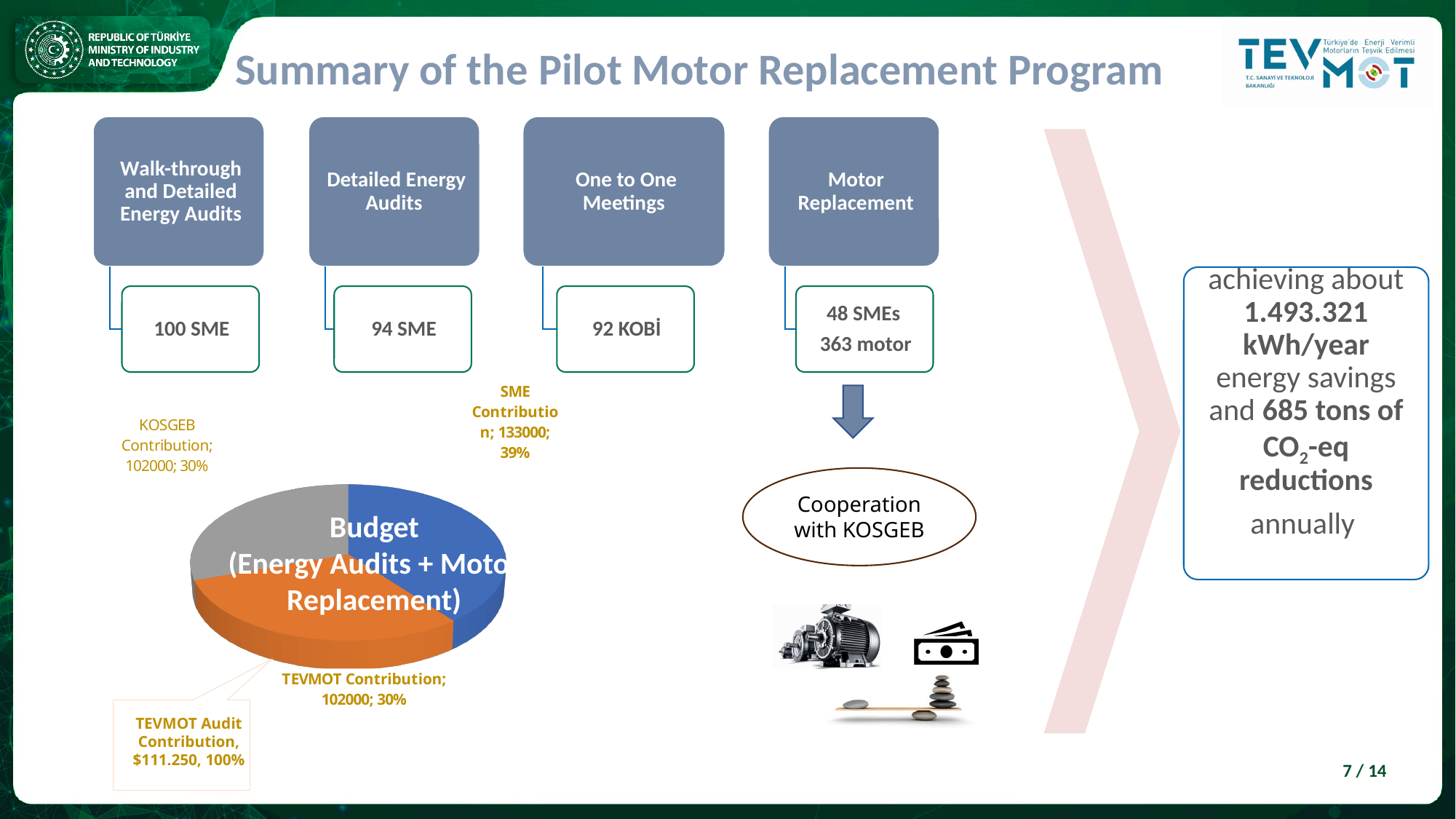
What is the value of the SME Contribution slice in the Budget pie chart? 133000 What share of the Budget pie chart does the SME Contribution slice represent? 39% What is the total of the three contributions shown in the Budget pie chart? 337000 How many slices does the Budget pie chart have? 3 What is the value of the TEVMOT Contribution slice in the Budget pie chart? 102000 Which is larger in the Budget pie chart, the SME Contribution or the TEVMOT Contribution? SME Contribution What is the title of the pie chart? Budget (Energy Audits + Motor Replacement) What is the difference between the SME Contribution and the KOSGEB Contribution in the Budget pie chart? 31000 What share of the Budget pie chart does the KOSGEB Contribution slice represent? 30% Which slice of the Budget pie chart is the largest? SME Contribution What kind of chart is shown on the slide? pie chart What is the value of the KOSGEB Contribution slice in the Budget pie chart? 102000